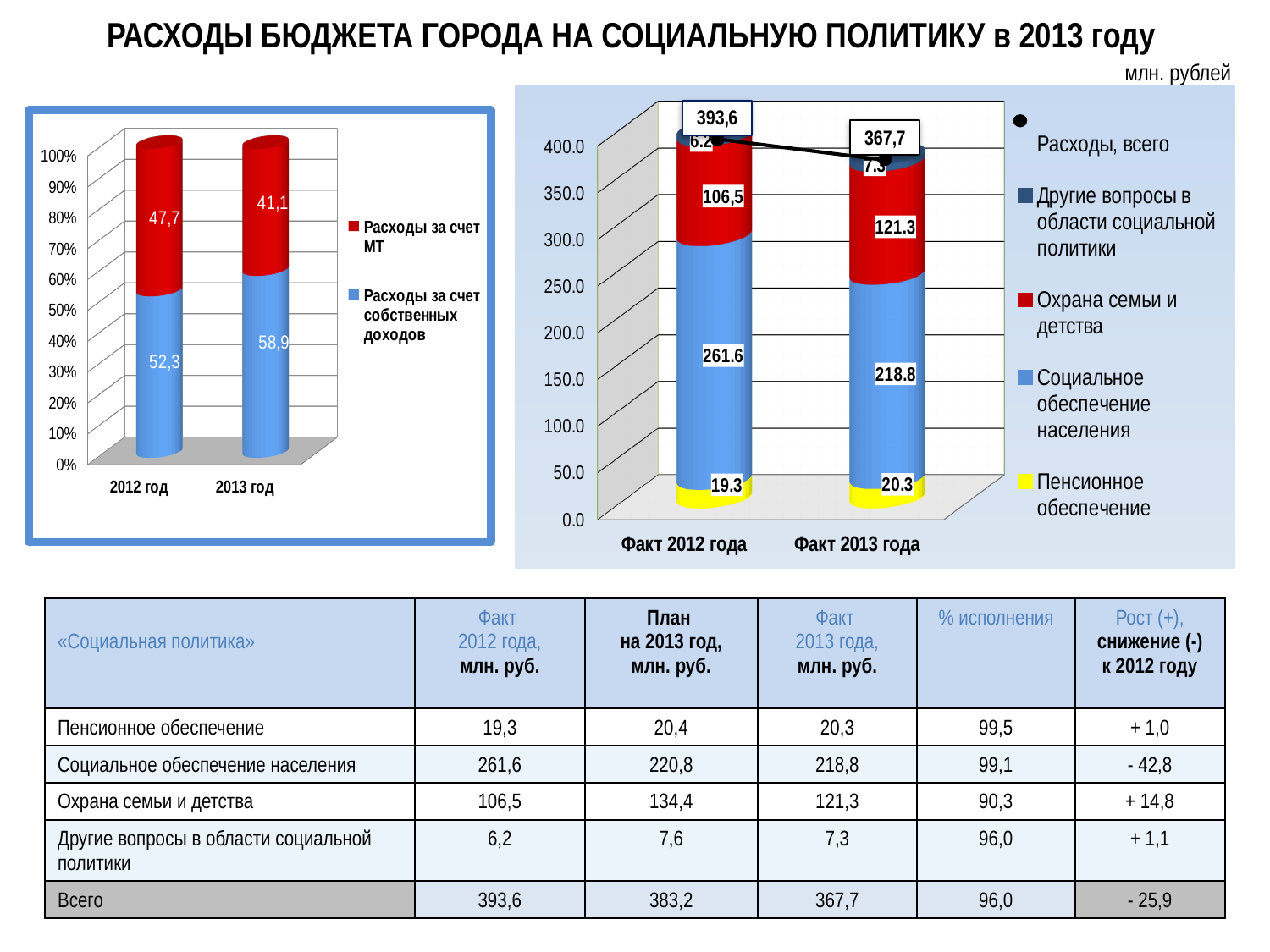
In the right chart, which segment is the smallest for Факт 2012 года? Другие вопросы в области социальной политики In the right chart, what is the value for 'Социальное обеспечение населения' for Факт 2012 года? 261.6 In the right chart, what is the value for 'Охрана семьи и детства' for Факт 2013 года? 121.3 In the right chart, which is larger: 'Охрана семьи и детства' for Факт 2012 года or for Факт 2013 года? Факт 2013 года What kind of chart is the right chart? stacked bar chart with a line In the left chart, what is the value for 'Расходы за счет МТ' in 2012 год? 47,7 In the left chart, does the share of 'Расходы за счет собственных доходов' rise or fall from 2012 год to 2013 год? rise In the left chart, how many series does the legend list? 2 In the right chart, how many categories are shown on the x axis? 2 In the left chart, what is the value for 'Расходы за счет собственных доходов' in 2013 год? 58,9 In the right chart, what is the value of 'Расходы, всего' for Факт 2013 года? 367,7 In the right chart, what is the difference between 'Социальное обеспечение населения' for Факт 2012 года and Факт 2013 года? 42.8